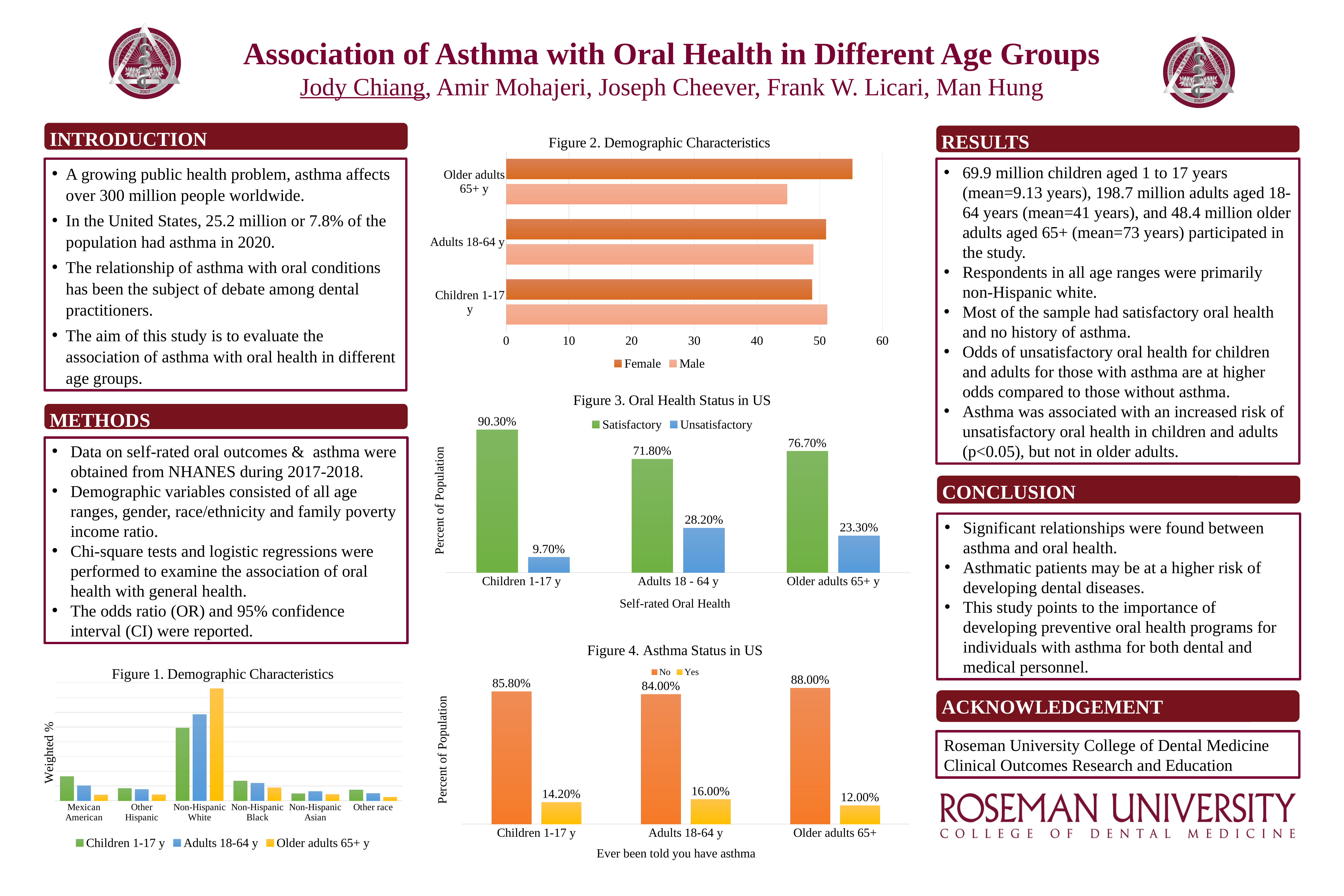
In Figure 1. Demographic Characteristics, which category has the highest value for Older adults 65+ y? Non-Hispanic White In Figure 1. Demographic Characteristics, how many race/ethnicity categories are shown on the x axis? 6 In Figure 4. Asthma Status in US, which age group has the lowest Yes value? Older adults 65+ In Figure 4. Asthma Status in US, what is the Yes value for Adults 18-64 y? 16.00% In Figure 3. Oral Health Status in US, what is the difference between the Satisfactory and Unsatisfactory values for Older adults 65+ y? 53.40% In Figure 4. Asthma Status in US, what is the difference between the No values for Older adults 65+ and Adults 18-64 y? 4.00% In Figure 4. Asthma Status in US, which is larger: the Yes value for Children 1-17 y or the Yes value for Older adults 65+? Children 1-17 y In Figure 3. Oral Health Status in US, what is the Satisfactory value for Children 1-17 y? 90.30% In Figure 2. Demographic Characteristics, is the Female value for Older adults 65+ y greater or less than 50? greater In Figure 2. Demographic Characteristics, is the Male value for Older adults 65+ y greater or less than 50? less In Figure 3. Oral Health Status in US, what is the Unsatisfactory value for Adults 18 - 64 y? 28.20% In Figure 3. Oral Health Status in US, which age group has the highest Unsatisfactory value? Adults 18 - 64 y